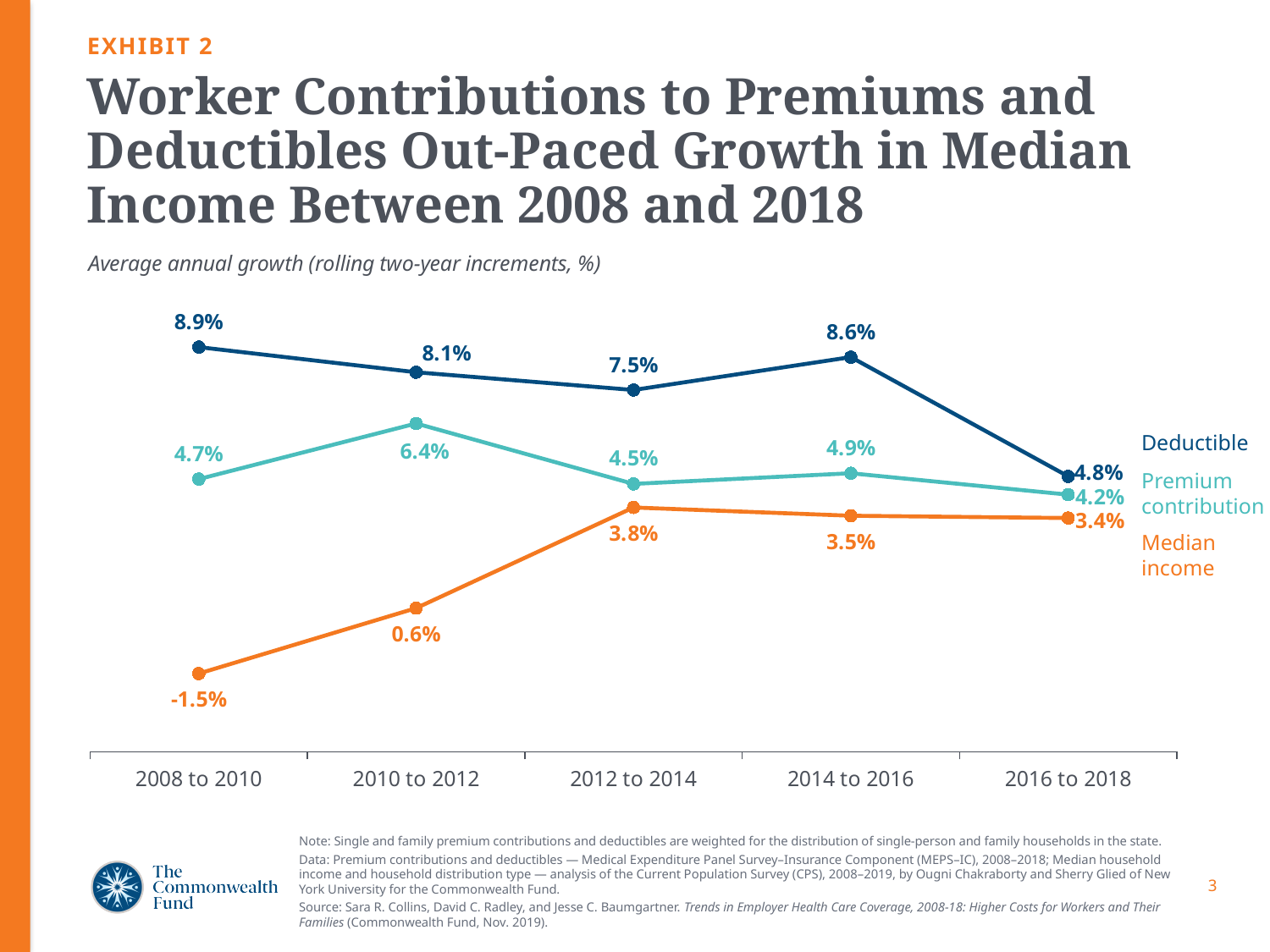
In which period is the Deductible value lowest? 2016 to 2018 Which is larger for 2010 to 2012: Deductible or Premium contribution? Deductible In which period is the Premium contribution value highest? 2010 to 2012 What is the Median income value for 2010 to 2012? 0.6% Does the Median income series rise or fall from 2008 to 2010 to 2012 to 2014? rise What kind of chart is this? line chart How many series does the chart show? 3 What is the Median income value for 2008 to 2010? -1.5% What is the Premium contribution value for 2014 to 2016? 4.9% How many periods are shown on the x axis? 5 What is the Deductible value for 2008 to 2010? 8.9% What is the difference between the Deductible and Median income values for 2012 to 2014? 3.7%